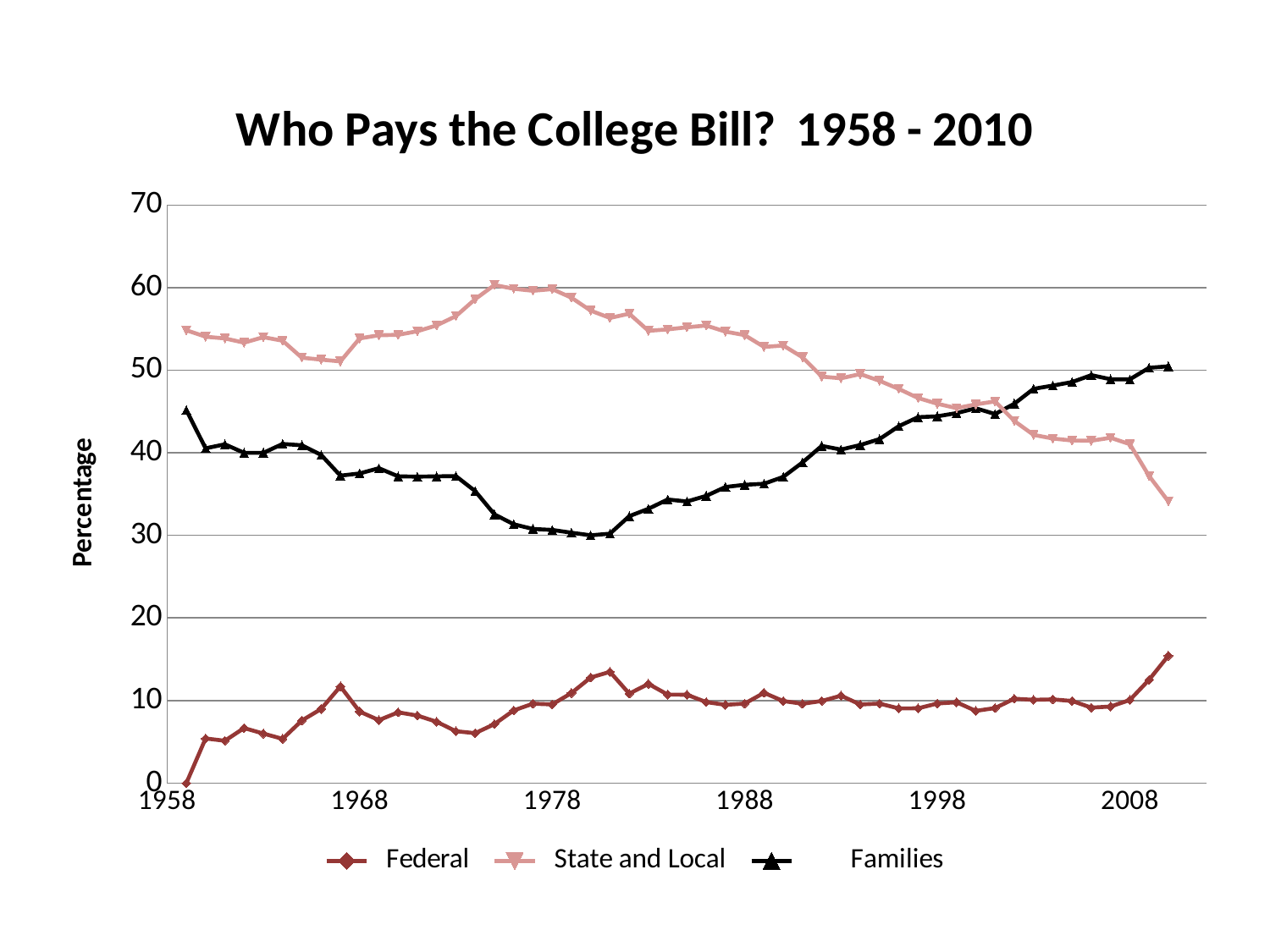
Is the value for State and Local in 1968 greater or less than 50? greater Which series has the highest value in 1978? State and Local How many series does the legend list? 3 What is the label on the vertical axis? Percentage Which series has the lowest value in 2008? Federal What kind of chart is shown on the slide? line chart Does the Families series rise or fall between 1998 and 2008? rise In 2008, which is larger: Families or State and Local? Families Is the value for Families in 1988 greater or less than 40? less Is the value for Federal in 1968 greater or less than 10? less What is the title of the chart? Who Pays the College Bill? 1958 - 2010